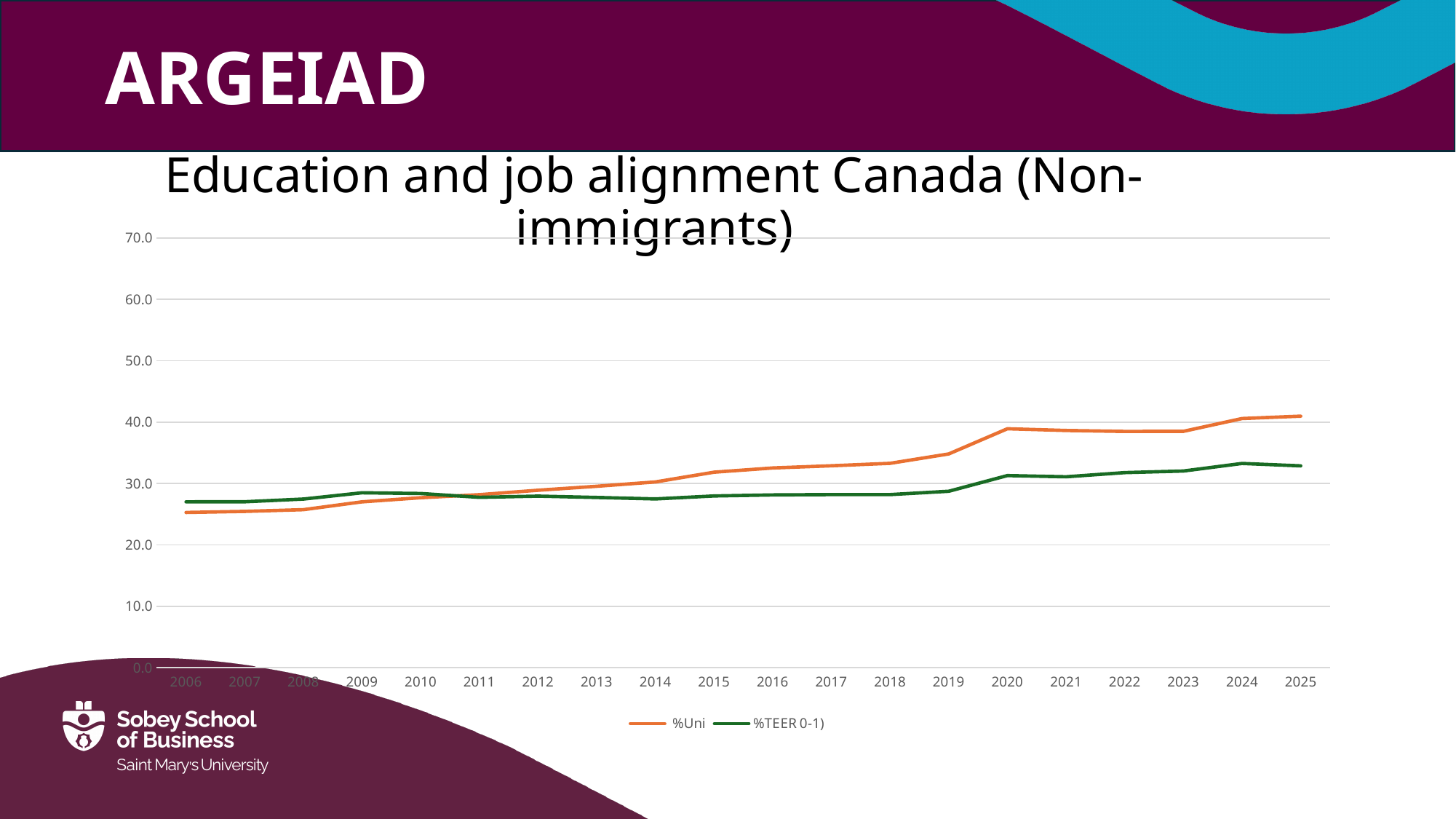
How many years are shown on the x axis? 20 Is the value for %TEER 0-1) in 2025 greater or less than 40.0? less In 2020, which series has the higher value, %Uni or %TEER 0-1)? %Uni What is the title of the chart? Education and job alignment Canada (Non-immigrants) Is the value for %Uni in 2006 greater or less than 30.0? less In 2025, which series has the higher value, %Uni or %TEER 0-1)? %Uni Is the value for %TEER 0-1) in 2006 greater or less than 30.0? less What are the two series named in the legend? %Uni and %TEER 0-1) Does the %Uni series generally rise or fall from 2006 to 2025? Rise How many series does the legend list? 2 What kind of chart is shown on the slide? Line chart